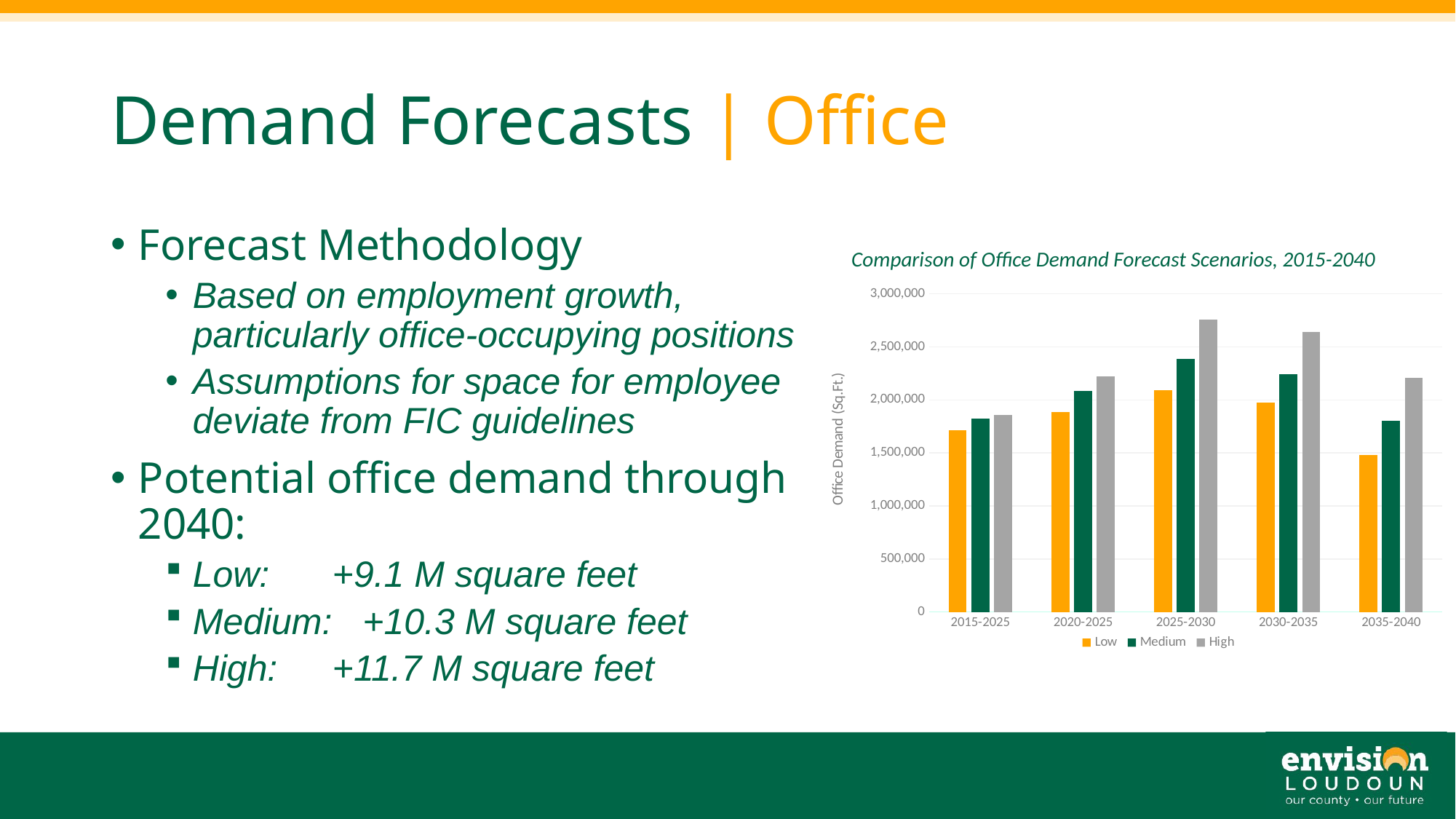
Which is larger: the Medium value for 2020-2025 or the Medium value for 2035-2040? 2020-2025 Which is larger: the High value for 2025-2030 or the High value for 2030-2035? 2025-2030 Is the High value for 2025-2030 greater or less than 2,500,000? greater Do the Low scenario values rise or fall from 2025-2030 to 2035-2040? fall Is the Low value for 2015-2025 greater or less than 2,000,000? less What is the title of the chart? Comparison of Office Demand Forecast Scenarios, 2015-2040 How many series does the chart legend list? 3 What kind of chart is shown on the slide? bar chart In which period is the Low scenario bar the shortest? 2035-2040 How many time periods are shown on the x axis of the chart? 5 In which period is the High scenario bar the tallest? 2025-2030 Is the Medium value for 2035-2040 greater or less than 2,000,000? less